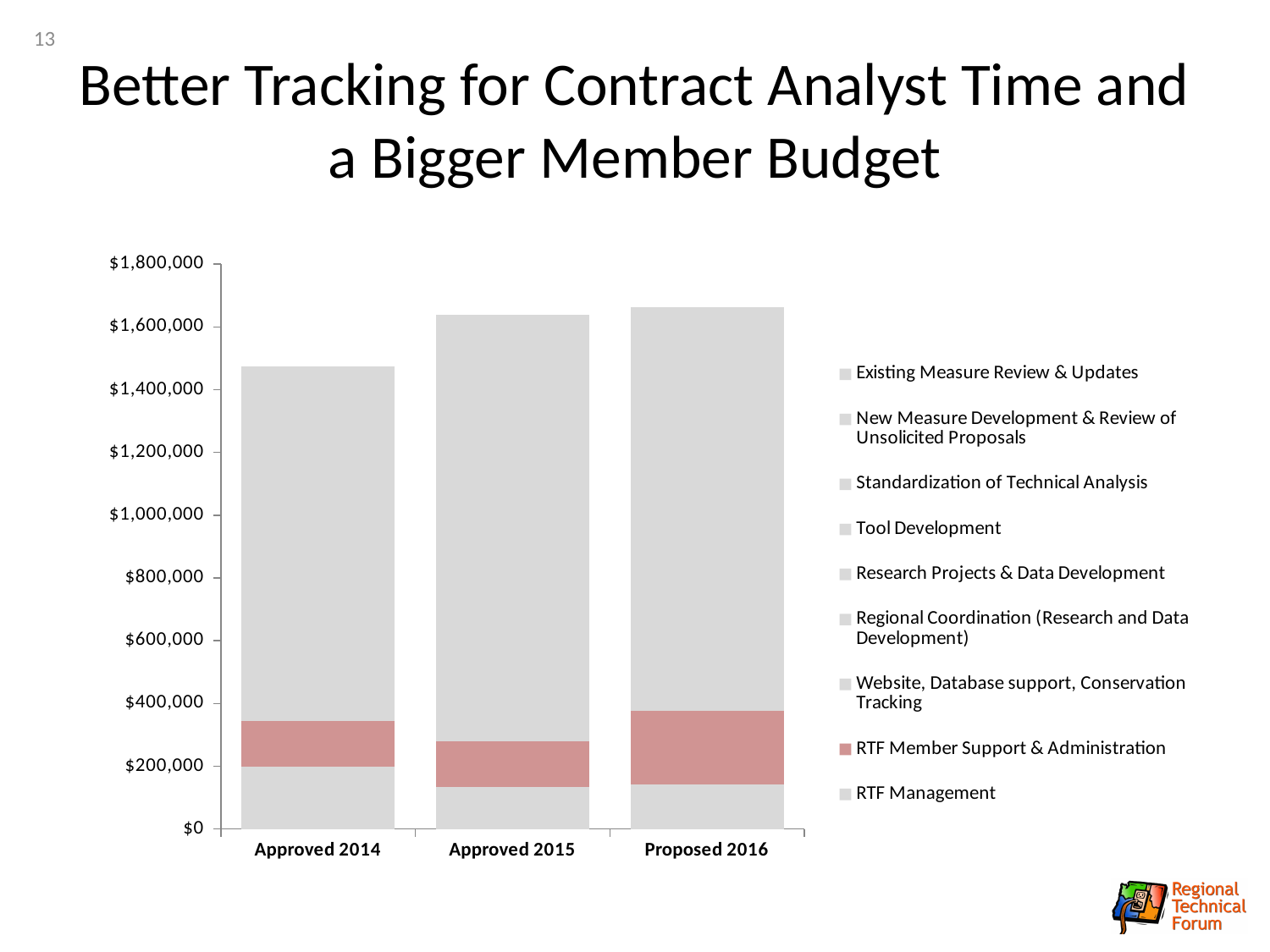
Do the total bar heights rise or fall from Approved 2014 to Proposed 2016? rise Which budget year has the lowest total bar? Approved 2014 Is the total for Approved 2014 greater or less than $1,600,000? less Which legend series is shown in pink/red rather than grey? RTF Member Support & Administration Is the total for Proposed 2016 greater or less than $1,600,000? greater Is the total for Approved 2014 greater or less than $1,400,000? greater Which series is listed last in the legend? RTF Management Is the total for Approved 2015 larger or smaller than the total for Approved 2014? larger How many series does the legend list? 9 What kind of chart is shown on the slide? Stacked bar chart How many budget years (categories) are shown on the x axis? 3